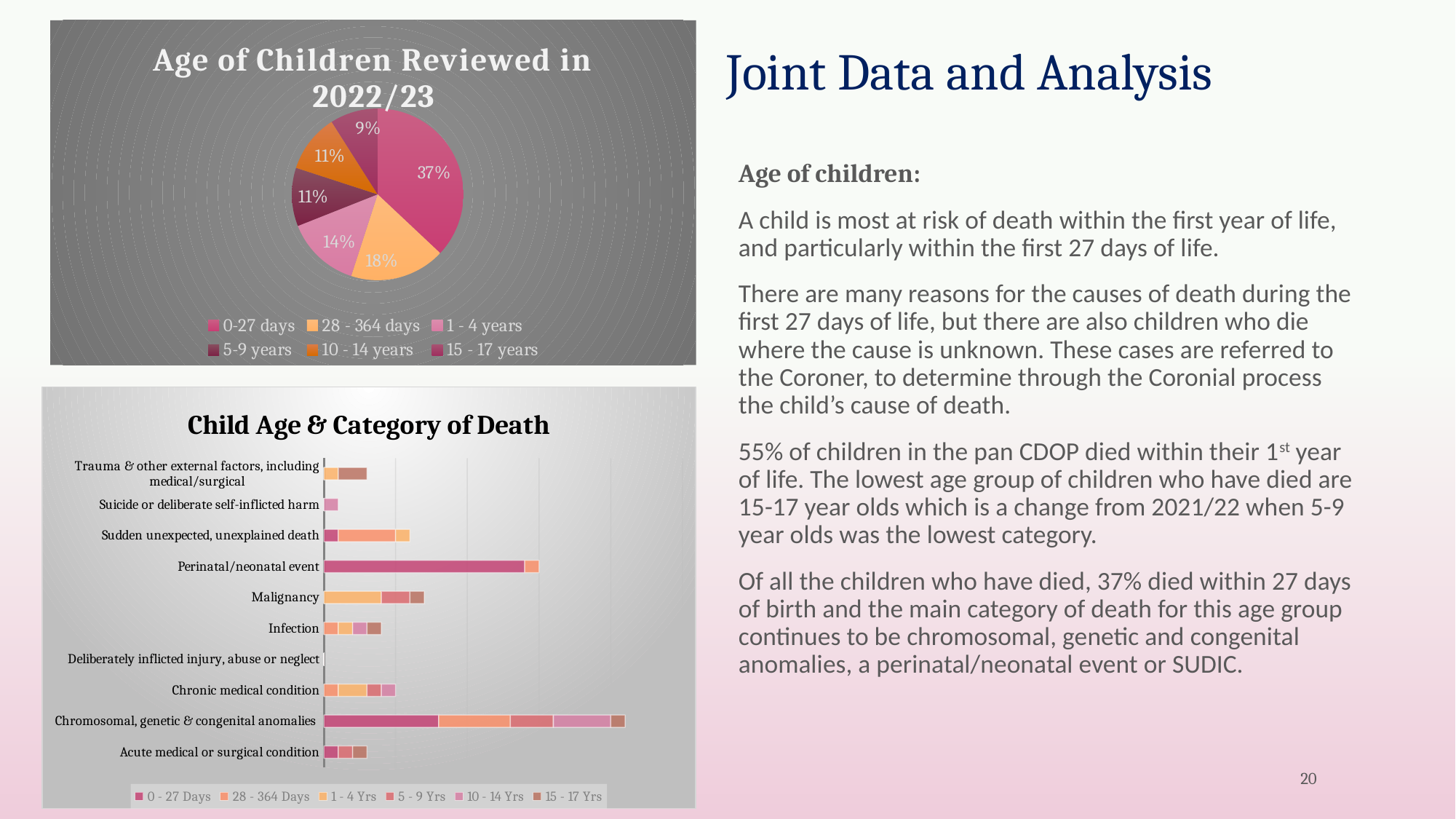
How many age groups does the legend of the pie chart 'Age of Children Reviewed in 2022/23' list? 6 What kind of chart is 'Child Age & Category of Death'? Stacked bar chart In the chart 'Child Age & Category of Death', how many series does the legend list? 6 In the chart 'Child Age & Category of Death', which category of death has the longest total bar? Chromosomal, genetic & congenital anomalies In the pie chart 'Age of Children Reviewed in 2022/23', which age group has the largest share? 0-27 days In the pie chart 'Age of Children Reviewed in 2022/23', what share is shown for 1 - 4 years? 14% In the pie chart 'Age of Children Reviewed in 2022/23', what share is shown for 0-27 days? 37% What kind of chart is 'Age of Children Reviewed in 2022/23'? Pie chart In the pie chart 'Age of Children Reviewed in 2022/23', which age group has the smallest share? 15 - 17 years In the pie chart 'Age of Children Reviewed in 2022/23', what share is shown for 28 - 364 days? 18% In the chart 'Child Age & Category of Death', which has the longer total bar: Perinatal/neonatal event or Malignancy? Perinatal/neonatal event In the pie chart 'Age of Children Reviewed in 2022/23', how many percentage points larger is the 0-27 days share than the 28 - 364 days share? 19 percentage points